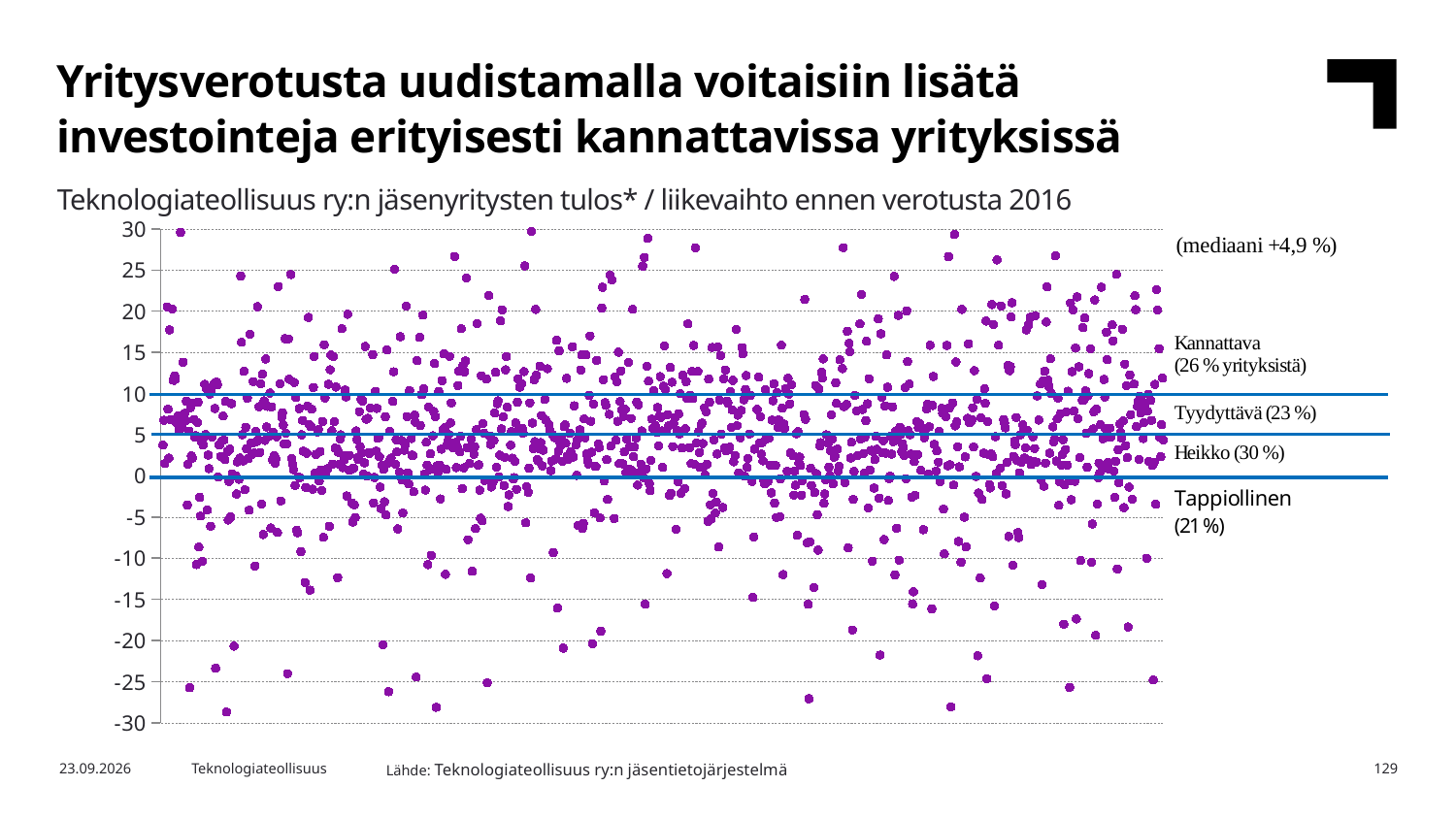
Which of the four labelled groups has the smallest share of companies? Tappiollinen Which group has a larger share of companies, Kannattava or Tyydyttävä? Kannattava Which of the four labelled groups has the largest share of companies? Heikko What is the title of the chart? Teknologiateollisuus ry:n jäsenyritysten tulos* / liikevaihto ennen verotusta 2016 What are the highest and lowest values shown on the vertical axis? 30 and -30 What is the difference in percentage points between the Heikko share and the Tappiollinen share? 9 What share of companies is labelled Tyydyttävä? 23 % What kind of chart is shown on the slide? scatter chart What share of companies is labelled Kannattava? 26 % What share of companies is labelled Tappiollinen? 21 % What median value is stated on the chart? +4,9 % What share of companies is labelled Heikko? 30 %